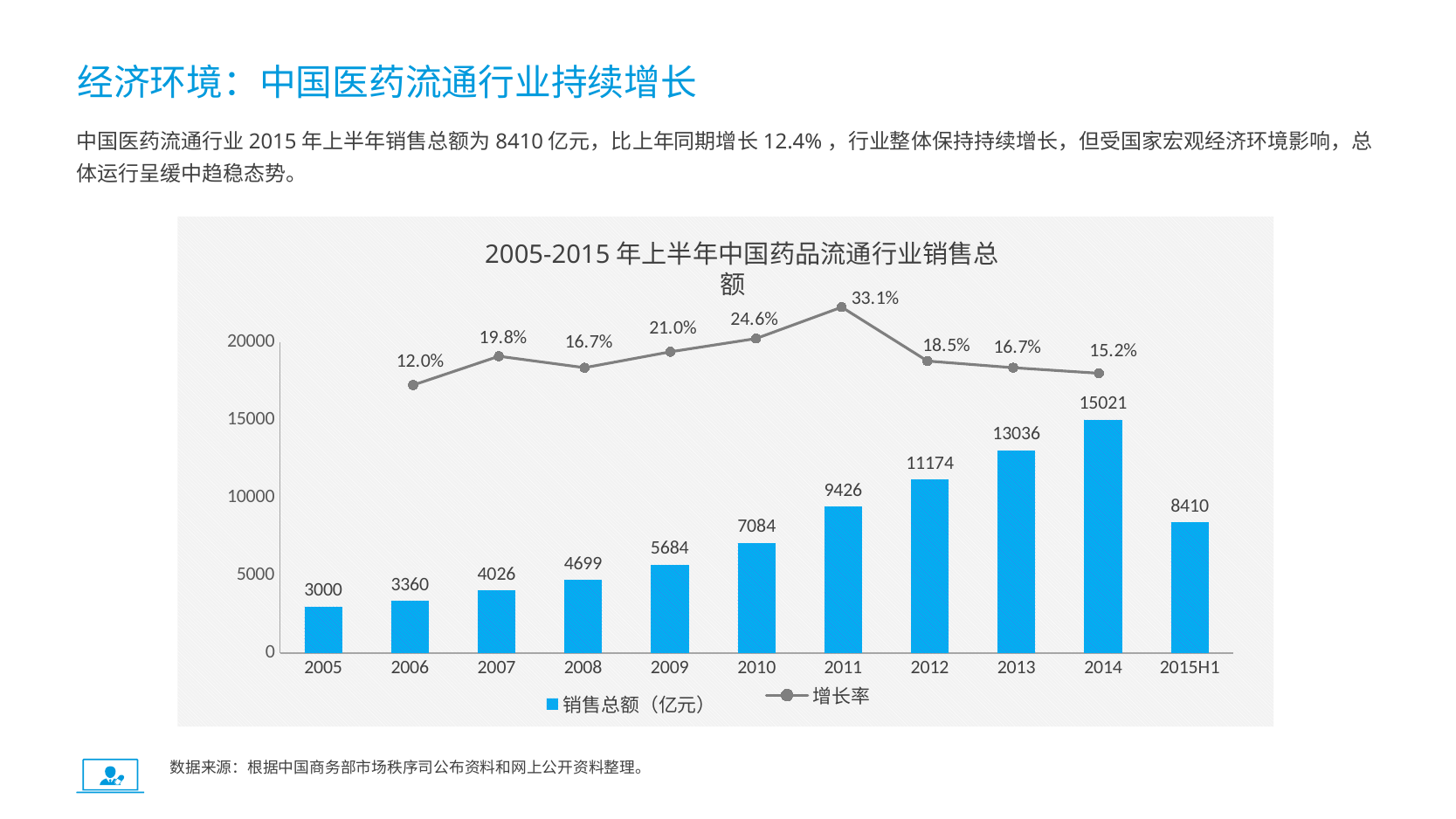
What is the sales total (销售总额) for 2014? 15021 Which year has the highest sales total (销售总额)? 2014 How many series does the legend list? 2 Which year has the lowest sales total (销售总额)? 2005 Which year has the highest growth rate (增长率)? 2011 What is the difference in sales total between 2014 and 2013? 1985 What is the sales total (销售总额) for 2015H1? 8410 What is the growth rate (增长率) shown for 2011? 33.1% Do the sales totals rise or fall from 2005 to 2014? rise How many categories are shown on the x axis? 11 Which is larger, the sales total for 2012 or for 2015H1? 2012 What is the growth rate (增长率) shown for 2006? 12.0%